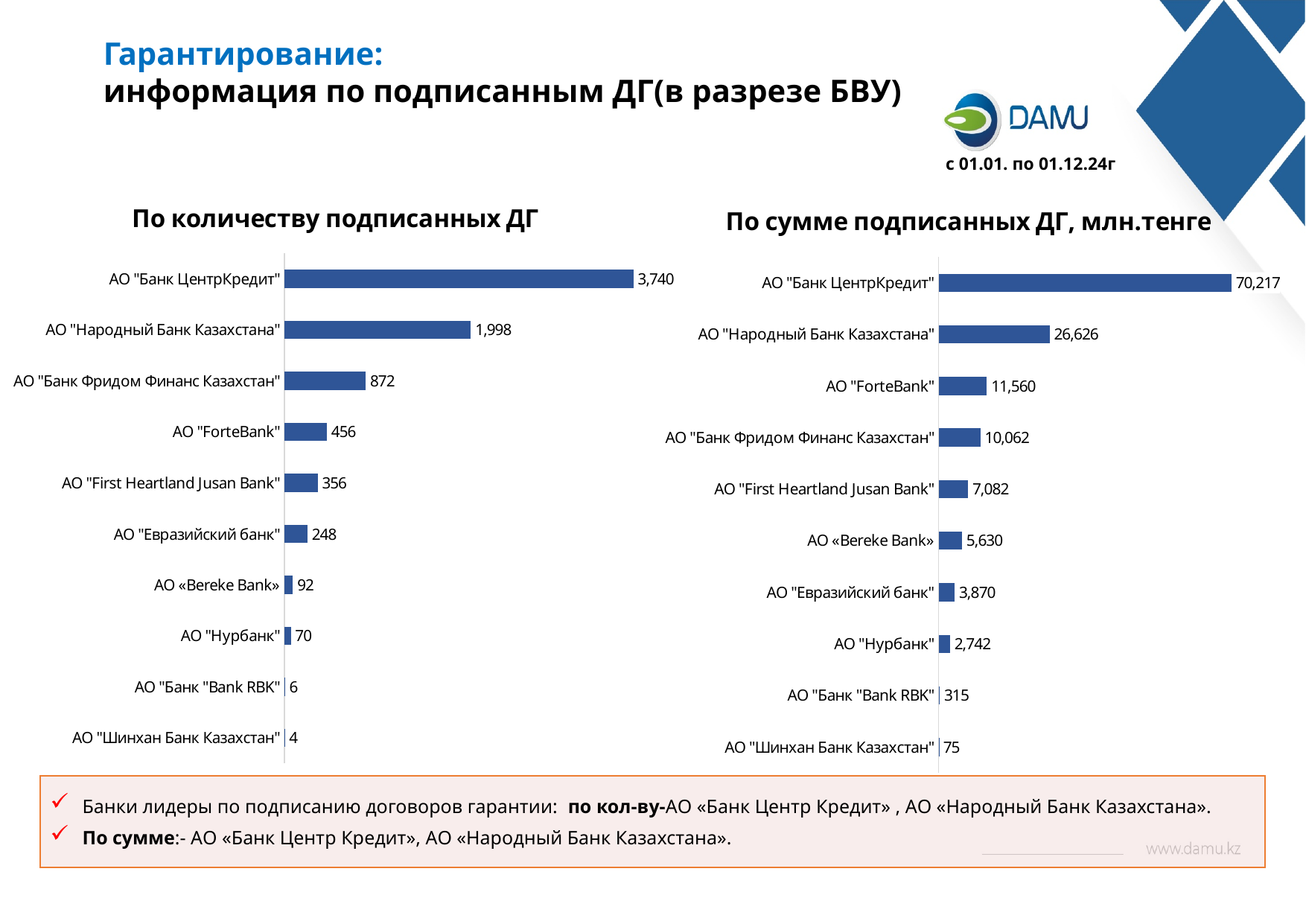
In the chart "По сумме подписанных ДГ, млн.тенге", what is the value for АО "Народный Банк Казахстана"? 26,626 In the chart "По количеству подписанных ДГ", which bank has the lowest value? АО "Шинхан Банк Казахстан" In the chart "По сумме подписанных ДГ, млн.тенге", which is larger: АО "Евразийский банк" or АО "Нурбанк"? АО "Евразийский банк" In the chart "По количеству подписанных ДГ", what is the value for АО "Банк ЦентрКредит"? 3,740 In the chart "По сумме подписанных ДГ, млн.тенге", which bank has the highest value? АО "Банк ЦентрКредит" In the chart "По количеству подписанных ДГ", what is the value for АО "Банк "Bank RBK"? 6 What type of chart is "По сумме подписанных ДГ, млн.тенге"? Bar chart How many banks are shown in the chart "По количеству подписанных ДГ"? 10 In the chart "По сумме подписанных ДГ, млн.тенге", what is the value for АО «Bereke Bank»? 5,630 In the chart "По количеству подписанных ДГ", what is the value for АО "ForteBank"? 456 In the chart "По количеству подписанных ДГ", what is the difference between АО "Банк ЦентрКредит" and АО "Народный Банк Казахстана"? 1,742 In the chart "По сумме подписанных ДГ, млн.тенге", what is the difference between АО "ForteBank" and АО "Банк Фридом Финанс Казахстан"? 1,498